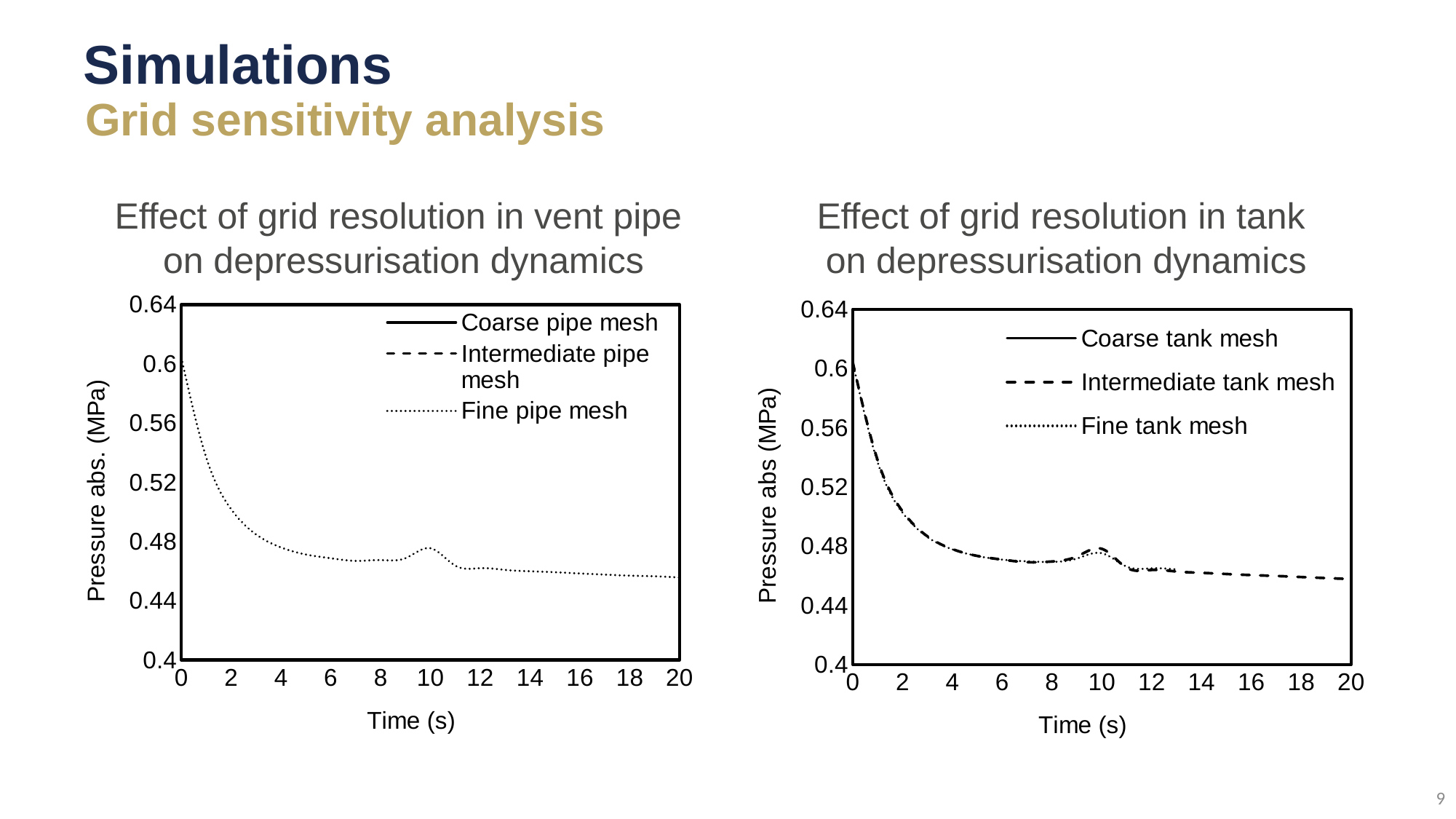
How many series does the legend of the left chart (vent pipe) list? 3 In the left chart (vent pipe), is the pressure at 0 s greater or less than 0.56 MPa? greater In the left chart (vent pipe), do the pressure values overall rise or fall as time increases from 0 to 20 s? Fall How many series does the legend of the right chart (tank) list? 3 In the right chart (tank), is the pressure at 20 s greater or less than 0.48 MPa? less What kind of chart is the right chart, 'Effect of grid resolution in tank on depressurisation dynamics'? Line chart What kind of chart is the left chart, 'Effect of grid resolution in vent pipe on depressurisation dynamics'? Line chart What is the y-axis label of the left chart (vent pipe)? Pressure abs. (MPa) In the right chart (tank), is the pressure at 6 s greater or less than 0.52 MPa? less What are the three legend entries of the right chart (tank)? Coarse tank mesh, Intermediate tank mesh, Fine tank mesh In the right chart (tank), do the pressure values overall rise or fall as time increases from 0 to 20 s? Fall